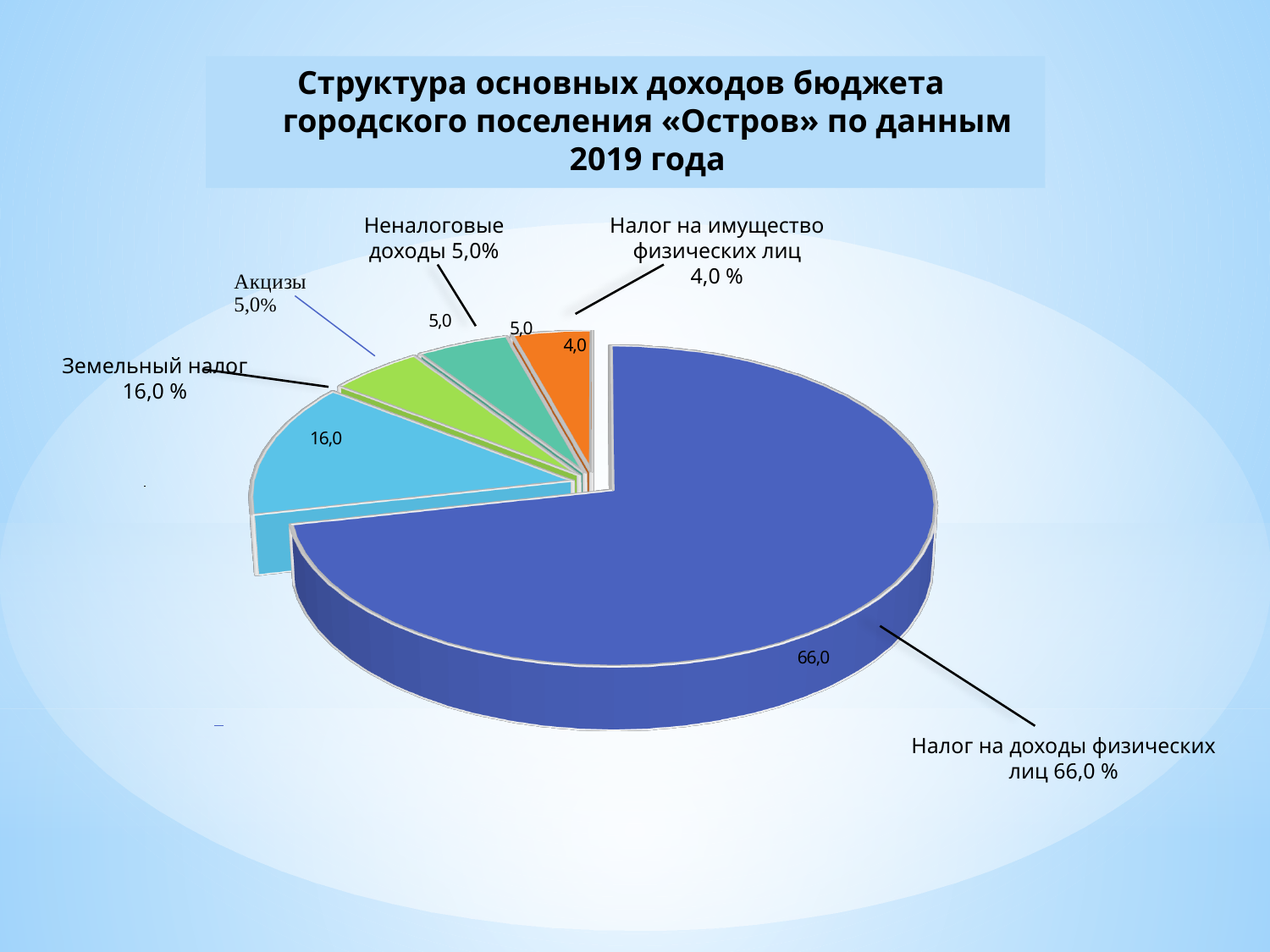
What is the difference between the values for Налог на доходы физических лиц and Земельный налог? 50,0 Which is larger, the value for Земельный налог or the value for Неналоговые доходы? Земельный налог What share of the pie does Земельный налог represent, according to the label on the slide? 16,0 % Which category has the largest slice of the pie? Налог на доходы физических лиц What year does the chart title say the data is from? 2019 What is the value shown for Налог на имущество физических лиц? 4,0 Which category has the smallest slice of the pie? Налог на имущество физических лиц What is the value shown for Земельный налог? 16,0 What is the value shown for Налог на доходы физических лиц? 66,0 How many slices does the pie chart have? 5 What is the value shown for Акцизы? 5,0 What kind of chart is shown on the slide? pie chart